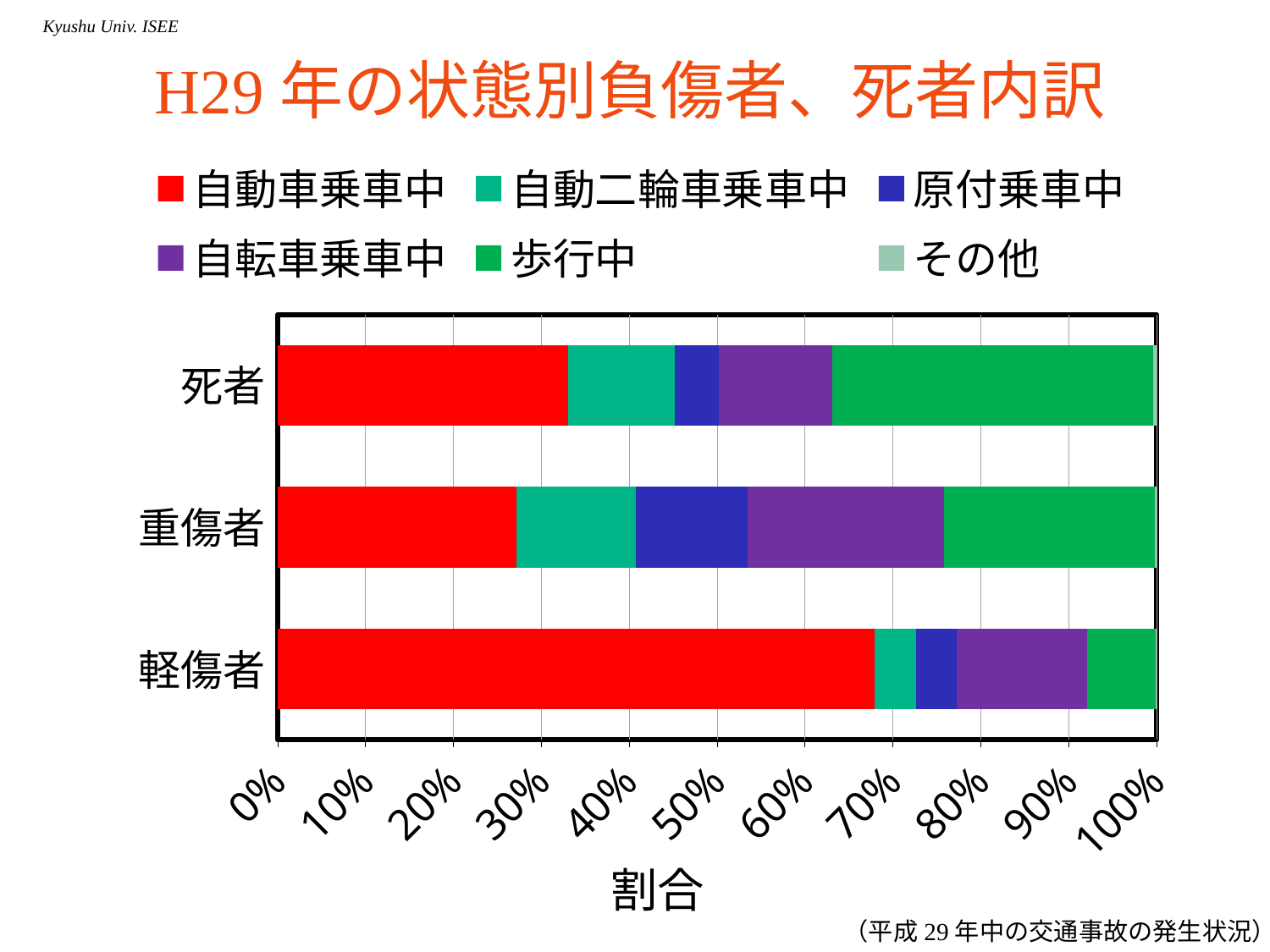
Which has the larger 自転車乗車中 share, 死者 or 重傷者? 重傷者 Is the 自動車乗車中 share for 重傷者 greater or less than 30%? less Which category has the largest 歩行中 share? 死者 What kind of chart is shown on the slide? stacked bar chart What is the title of the chart on the slide? H29年の状態別負傷者、死者内訳 What is the label of the horizontal axis? 割合 How many categories (bars) are plotted on the chart? 3 Which has the larger 原付乗車中 share, 重傷者 or 軽傷者? 重傷者 Which category has the largest 自動車乗車中 share? 軽傷者 Is the 自動車乗車中 share for 軽傷者 greater or less than 60%? greater Is the 自動車乗車中 share for 死者 greater or less than 40%? less How many series does the legend list? 6